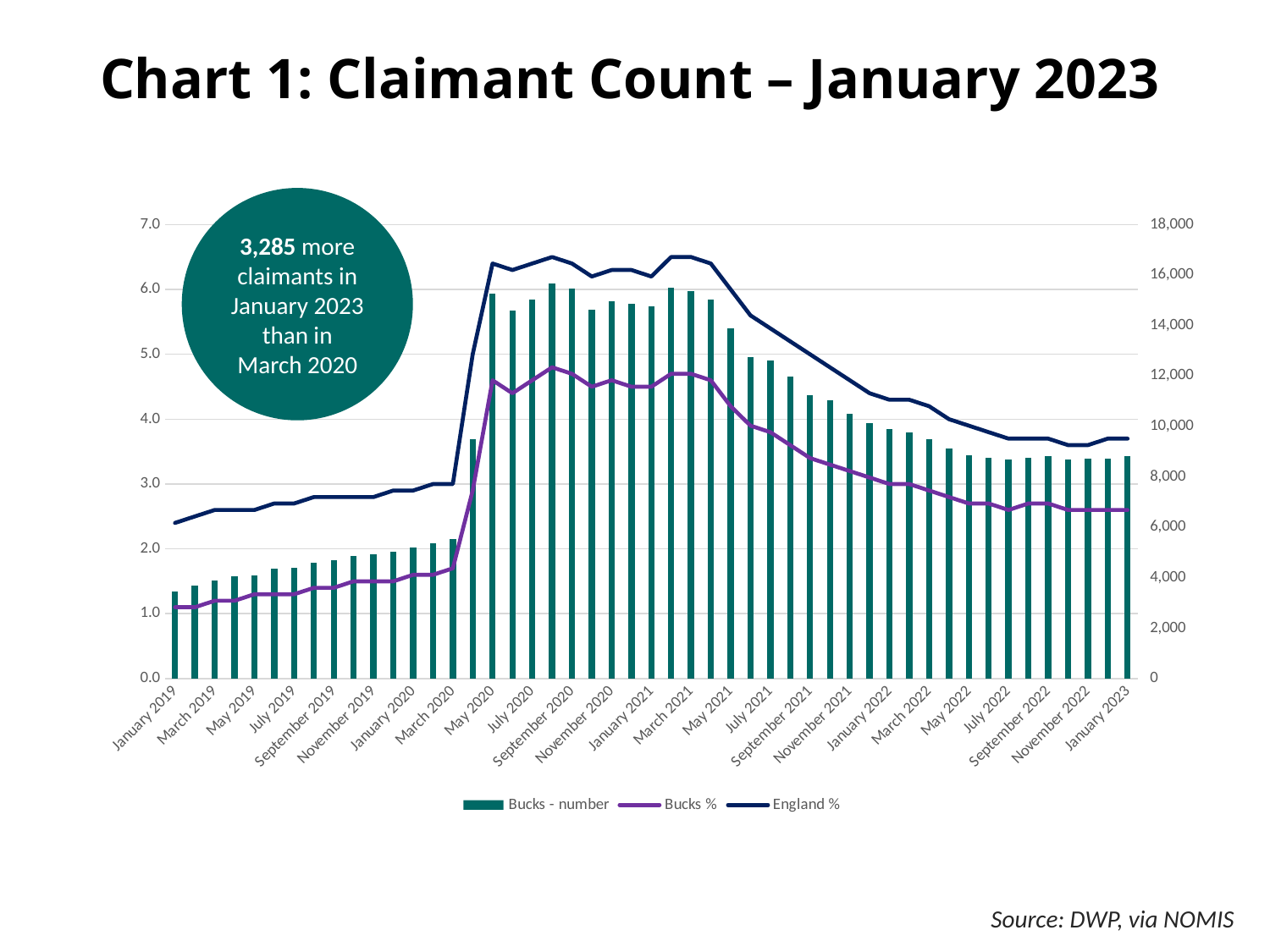
How many series does the legend list? 3 Is the England % value for May 2020 greater or less than 6.0? greater Does the Bucks - number series rise or fall between May 2021 and January 2023? fall In January 2023, which is higher: Bucks % or England %? England % Which month has the lowest value for Bucks - number? January 2019 Is the Bucks - number value for January 2023 greater or less than 8,000? greater What kind of chart is this? Combined bar and line chart Is the England % value for January 2023 greater or less than 3.0? greater Which month has the lowest England % value? January 2019 According to the callout on the chart, how many more claimants were there in January 2023 than in March 2020? 3,285